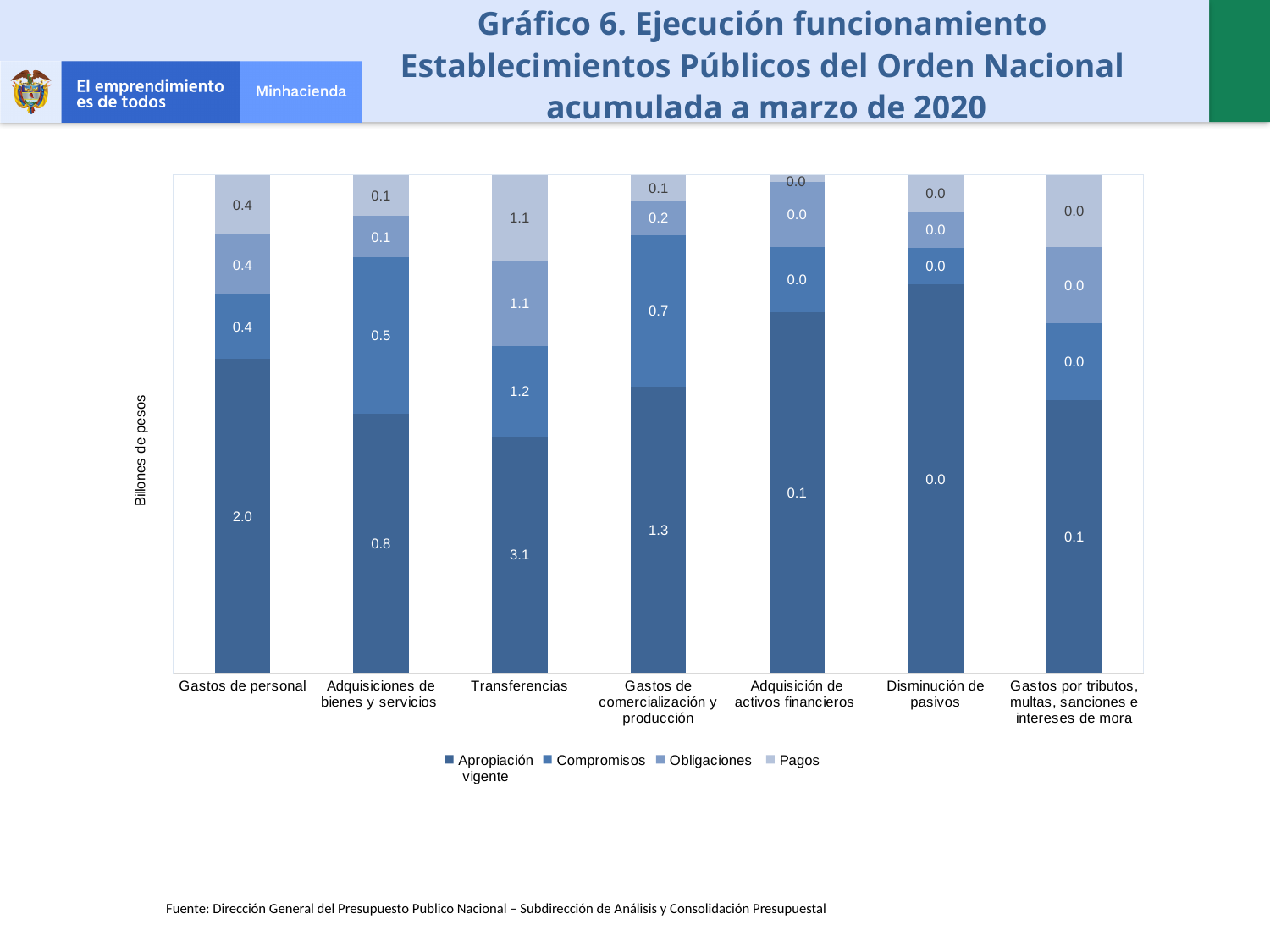
What is the sum of the four labelled values for Gastos de personal? 3.2 What is the label on the vertical axis of the chart? Billones de pesos Which is larger, the Compromisos value for Gastos de comercialización y producción or for Adquisiciones de bienes y servicios? Gastos de comercialización y producción What is the difference between the Apropiación vigente values for Transferencias and Gastos de personal? 1.1 Which category has the highest Apropiación vigente value? Transferencias What is the Pagos value for Adquisiciones de bienes y servicios? 0.1 What kind of chart is shown on the slide? Stacked bar chart How many series does the legend list? 4 How many categories are shown on the x axis? 7 What is the Obligaciones value for Gastos de comercialización y producción? 0.2 What is the Compromisos value for Transferencias? 1.2 What is the Apropiación vigente value for Gastos de personal? 2.0